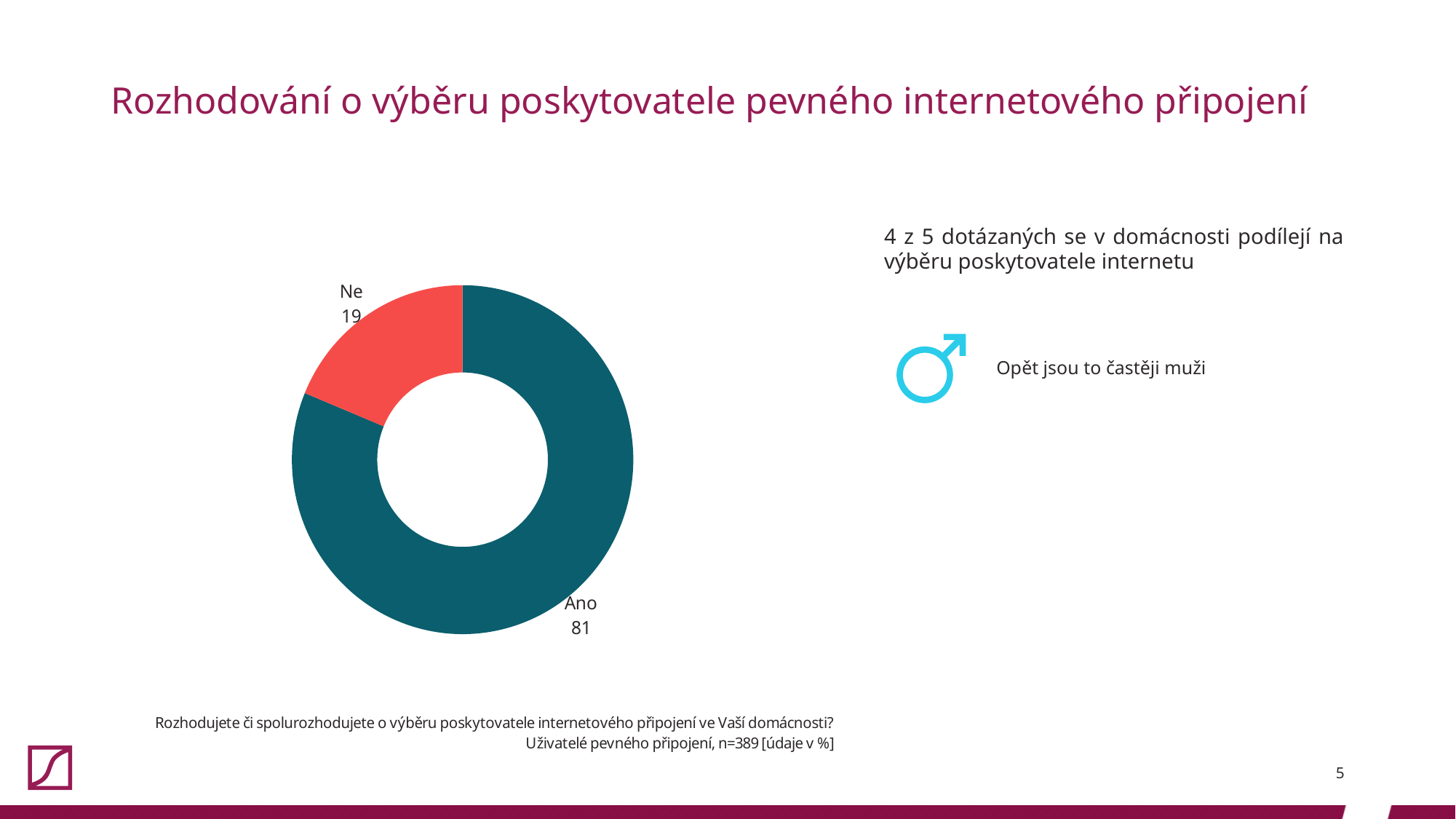
What kind of chart is shown on the slide? Doughnut chart What share of the chart does the "Ne" slice represent? 19% What is the total of the two slice values shown? 100 What is the difference between the values for "Ano" and "Ne"? 62 What colour is the "Ano" slice? Dark teal What value is shown for the "Ne" slice? 19 Which category has the smallest slice? Ne Which category has the largest slice? Ano What is the sample size (n) stated below the chart? 389 What value is shown for the "Ano" slice? 81 How many categories are shown in the chart? 2 Which is larger, the value for "Ano" or the value for "Ne"? Ano